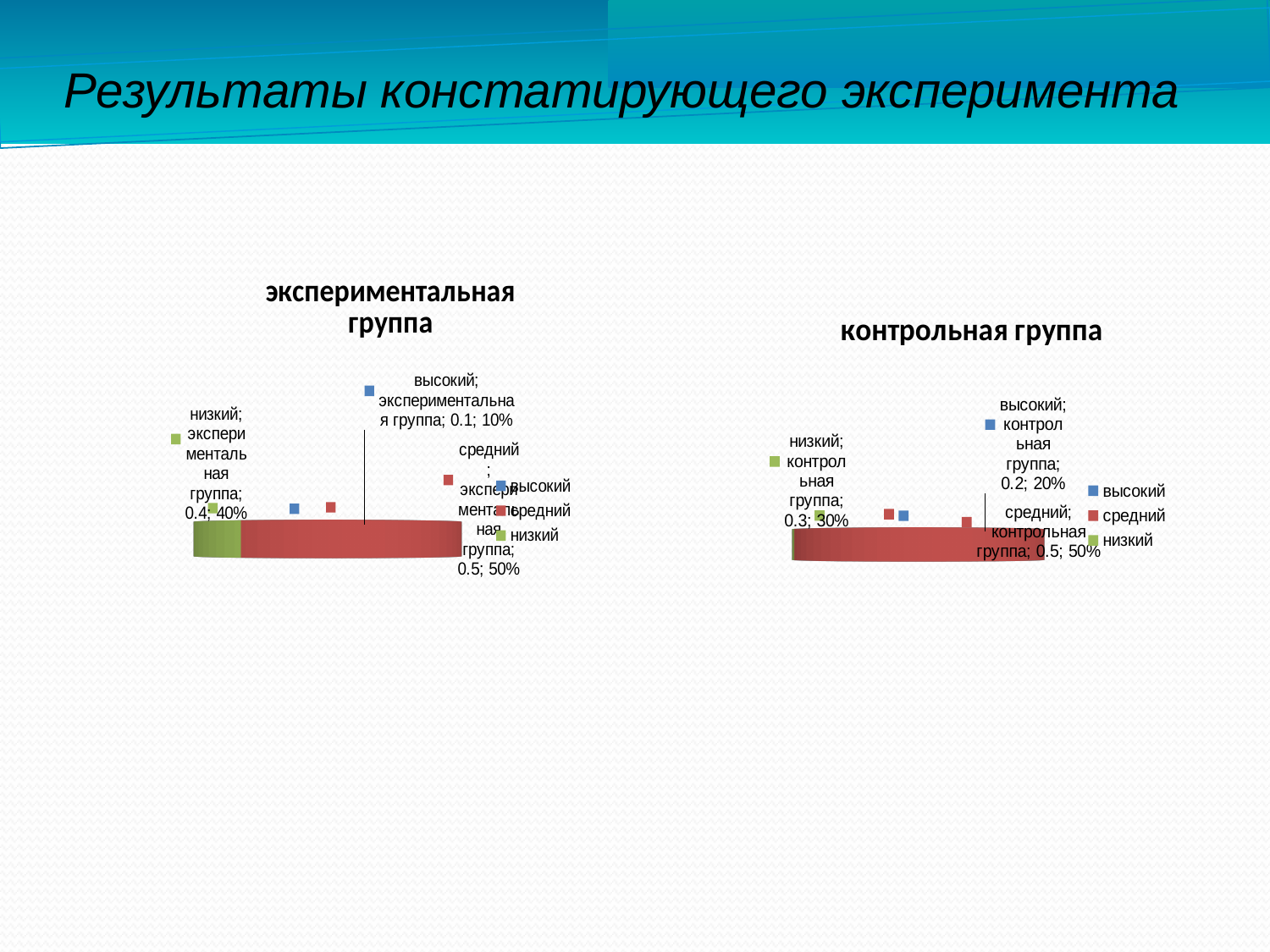
Which is larger in the "экспериментальная группа" chart: the share for "низкий" or the share for "высокий"? низкий How many entries does the legend of the "контрольная группа" chart list? 3 In the "экспериментальная группа" chart, which category has the smallest share? высокий In the "контрольная группа" chart, what percentage is shown for "высокий"? 20% In the "контрольная группа" chart, what is the difference in percentage points between "средний" and "высокий"? 30 What kind of chart is the "экспериментальная группа" chart? pie chart In the "экспериментальная группа" chart, what percentage is shown for "низкий"? 40% How many slices does the "экспериментальная группа" pie chart have? 3 In the "экспериментальная группа" chart, what percentage is shown for "средний"? 50% In the "контрольная группа" chart, what percentage is shown for "низкий"? 30% In the "контрольная группа" chart, which category has the largest share? средний In the "экспериментальная группа" chart, what percentage is shown for "высокий"? 10%